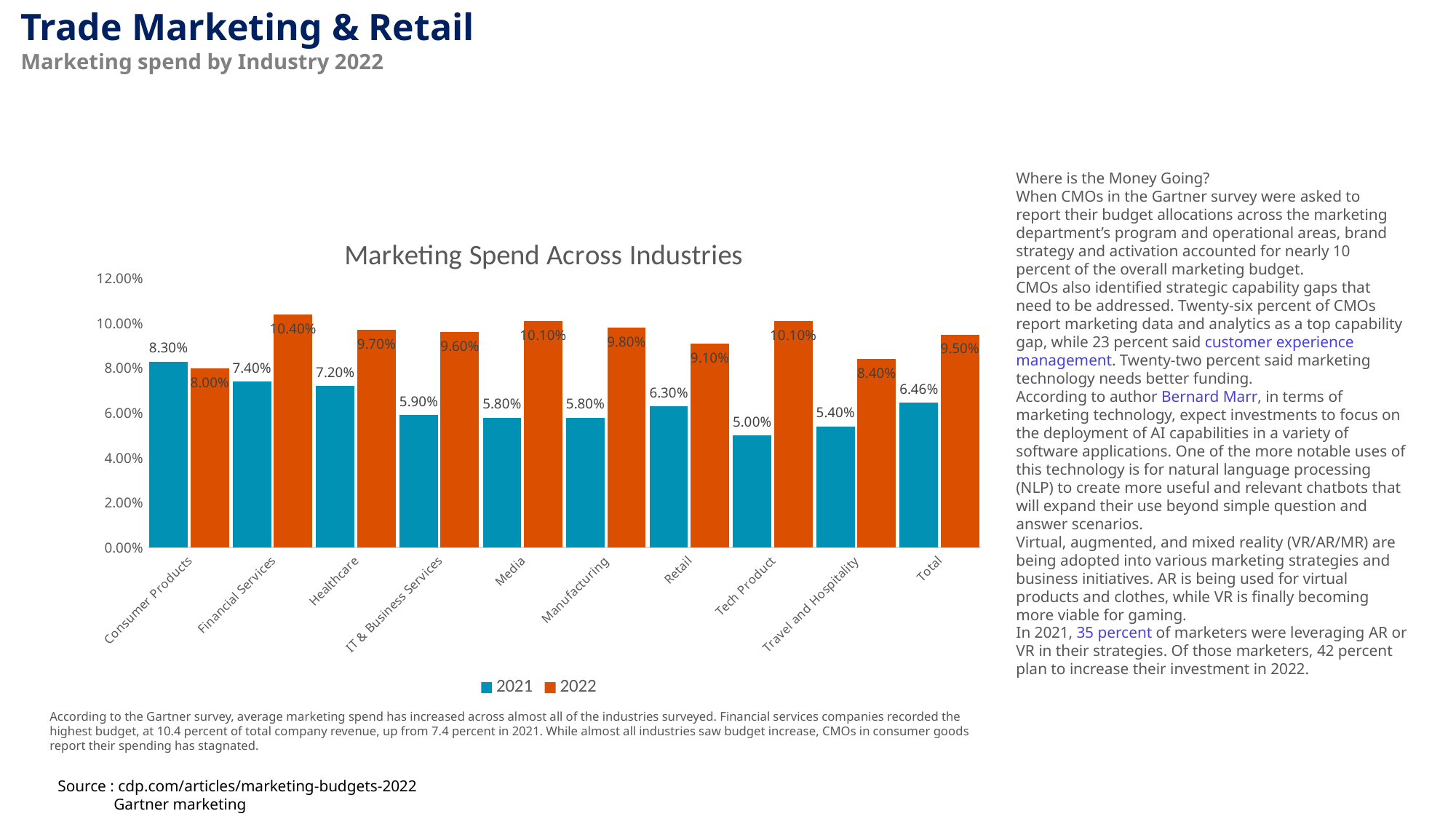
How many series does the chart legend list? 2 What type of chart is shown on the slide? Bar chart What is the difference between the 2022 and 2021 values for Healthcare? 2.50% Which industry has the lowest 2021 marketing spend? Tech Product How many categories are shown on the x axis of the chart? 10 Which industry has the highest 2022 marketing spend? Financial Services What is the title of the chart? Marketing Spend Across Industries For Consumer Products, which year has the larger value, 2021 or 2022? 2021 What is the 2022 marketing spend value for Financial Services? 10.40% What is the 2021 value shown for the Total category? 6.46% Is the 2022 value for Travel and Hospitality greater or less than 8.00%? greater What is the 2021 marketing spend value for Tech Product? 5.00%